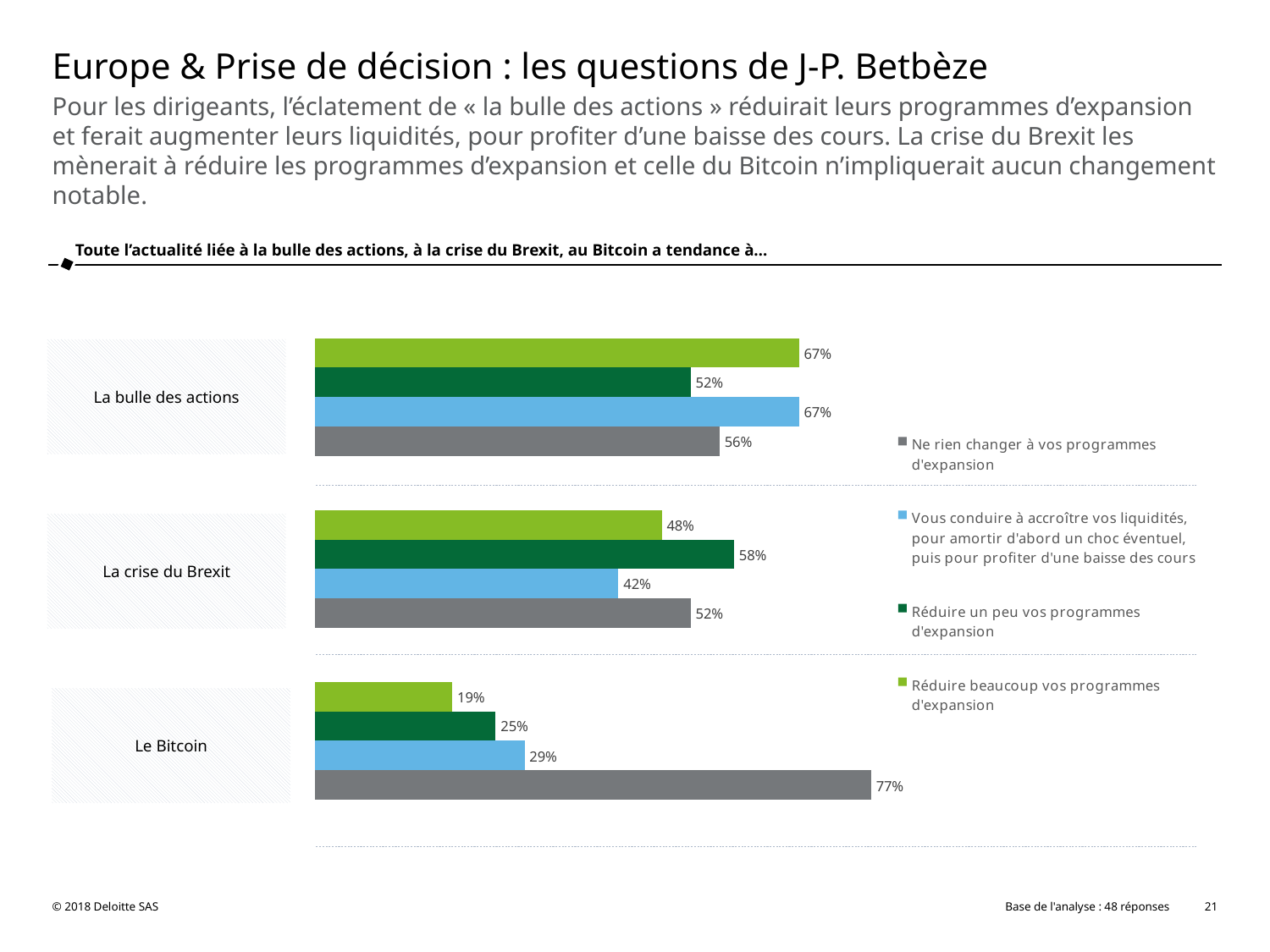
For La crise du Brexit, which is larger: "Réduire un peu vos programmes d'expansion" or "Vous conduire à accroître vos liquidités"? Réduire un peu vos programmes d'expansion What is the value for "Vous conduire à accroître vos liquidités" for Le Bitcoin? 29% Which category has the highest value for "Ne rien changer à vos programmes d'expansion"? Le Bitcoin What is the title of the chart? Toute l'actualité liée à la bulle des actions, à la crise du Brexit, au Bitcoin a tendance à… How many series does the legend list? 4 What is the value for "Ne rien changer à vos programmes d'expansion" for Le Bitcoin? 77% What is the difference between the "Ne rien changer" value for Le Bitcoin and for La crise du Brexit? 25% What kind of chart is shown on the slide? bar chart What is the value for "Réduire un peu vos programmes d'expansion" for La crise du Brexit? 58% What is the value for "Réduire beaucoup vos programmes d'expansion" for La bulle des actions? 67% Which category has the lowest value for "Réduire beaucoup vos programmes d'expansion"? Le Bitcoin How many categories are shown on the chart? 3